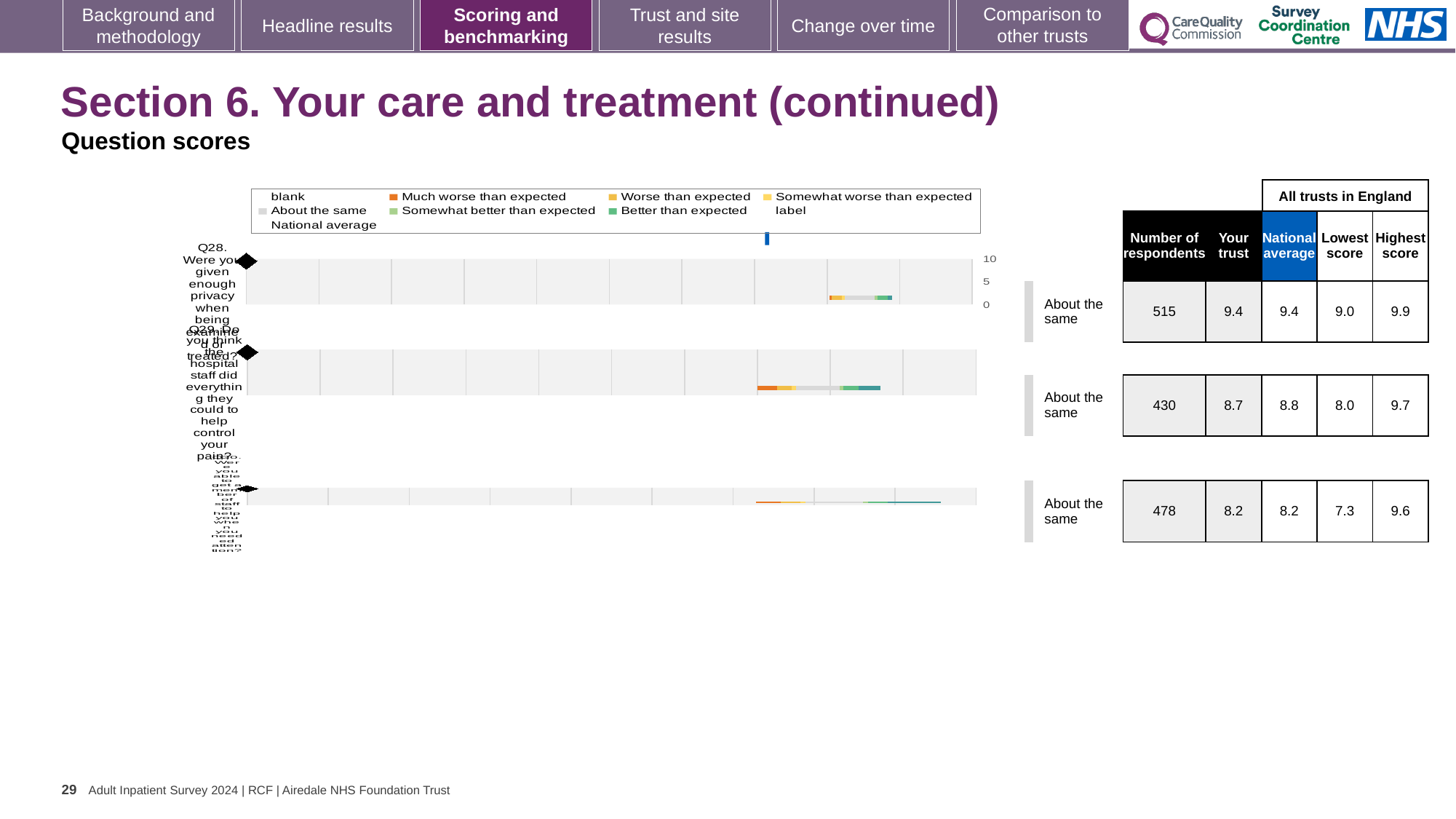
What is the 'Your trust' score for Q28 (Were you given enough privacy when being examined or treated?)? 9.4 How many respondents answered Q28 (privacy when being examined or treated)? 515 Which of the three questions on the slide has the lowest number of respondents? Q29 For Q29, is the 'Your trust' score higher or lower than the national average? lower What kind of chart is used to show the Q28 privacy question score? bar chart What is the lowest score among all trusts in England for the bottom chart (Q30)? 7.3 Which of the three questions on the slide has the highest 'Your trust' score? Q28 How many question charts are shown on the slide? 3 How many entries does the chart legend list? 9 What benchmark category label is shown next to the Q28 chart? About the same What is the national average score for Q29 (Do you think the hospital staff did everything they could to help control your pain?)? 8.8 For Q29, what is the difference between the highest score and the lowest score among all trusts in England? 1.7